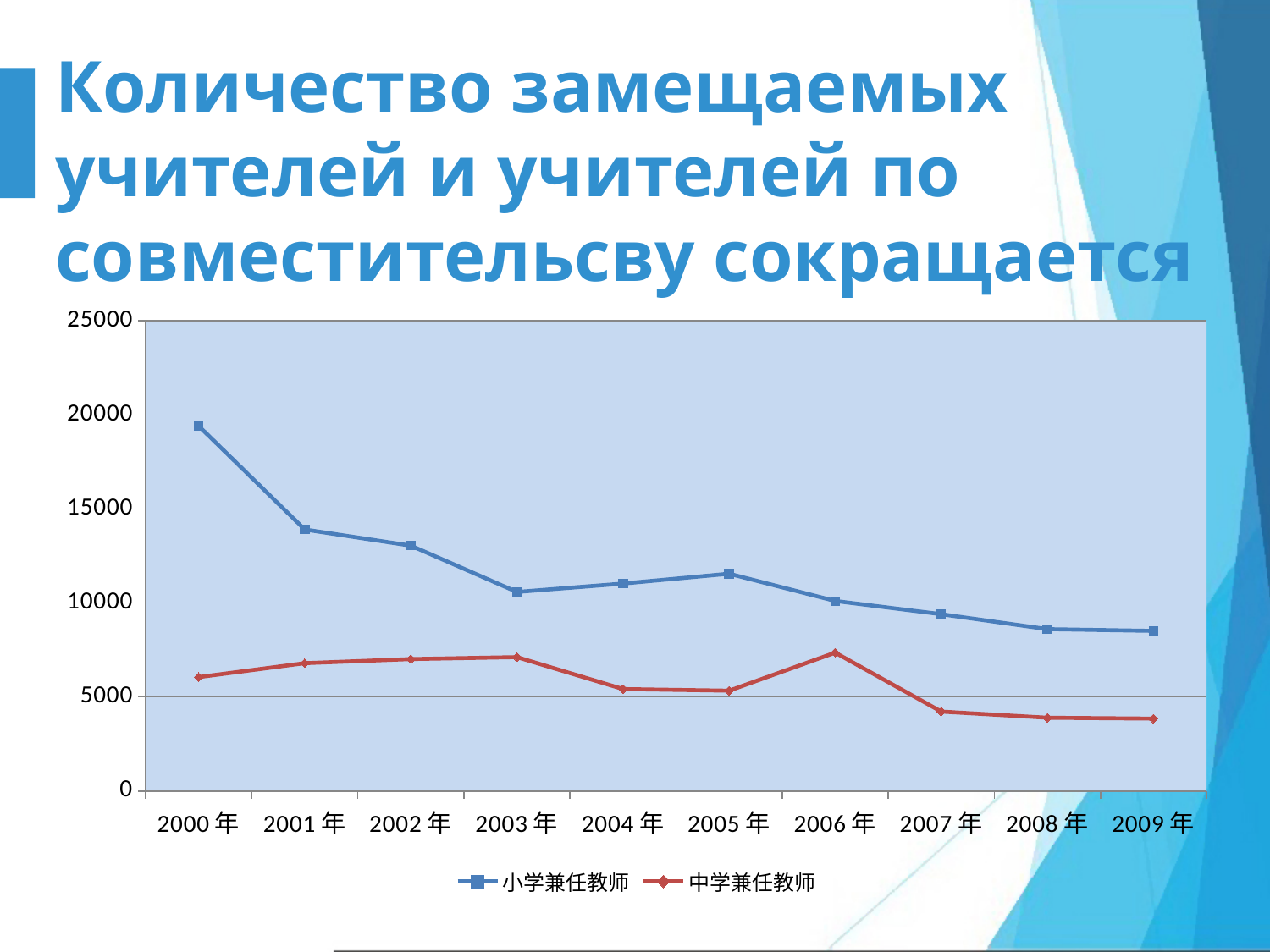
Does the value for 小学兼任教师 generally rise or fall from 2000年 to 2009年? fall Is the value for 中学兼任教师 in 2007年 greater or less than 5000? less How many series does the legend list? 2 Is the value for 小学兼任教师 in 2001年 greater or less than 15000? less How many years are plotted along the x axis? 10 Is the value for 中学兼任教师 in 2003年 greater or less than 5000? greater Which series has the larger value in 2000年, 小学兼任教师 or 中学兼任教师? 小学兼任教师 Which series is drawn with the red line? 中学兼任教师 In which year is the value for 小学兼任教师 highest? 2000年 What kind of chart is shown on the slide? line chart